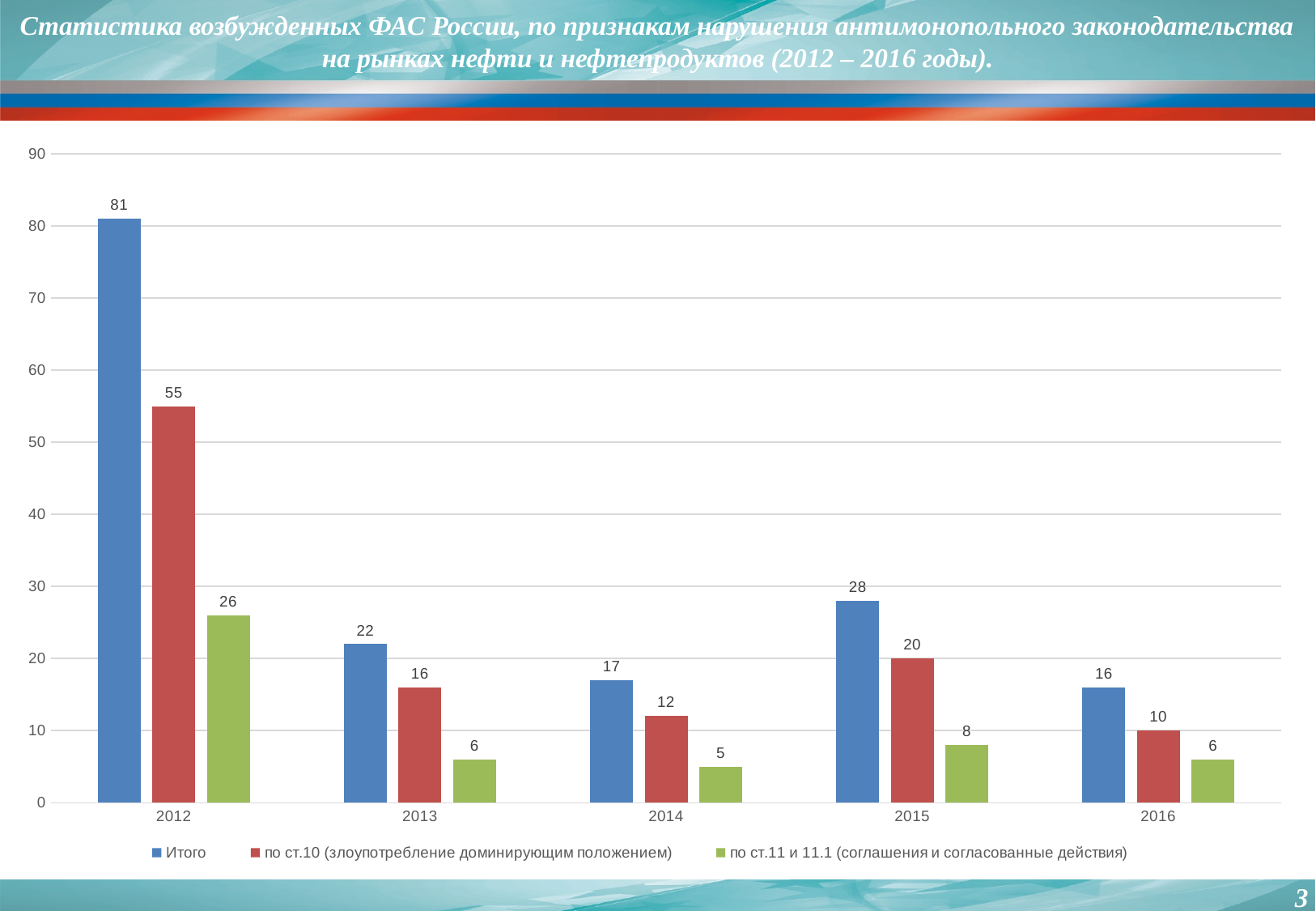
What is the difference between the "Итого" values for 2012 and 2013? 59 In which year is the "Итого" value highest? 2012 How many years are shown on the x axis? 5 What kind of chart is shown on the slide? bar chart Which colour represents the "Итого" series? blue What is the value of the "по ст.11 и 11.1 (соглашения и согласованные действия)" series for 2014? 5 Is the "по ст.10" value for 2012 greater or less than 50? greater In which year is the "Итого" value lowest? 2016 Which is larger: the "по ст.10" value for 2013 or for 2016? 2013 What is the value of the "Итого" series for 2012? 81 What is the value of the "по ст.10 (злоупотребление доминирующим положением)" series for 2015? 20 How many series does the legend list? 3